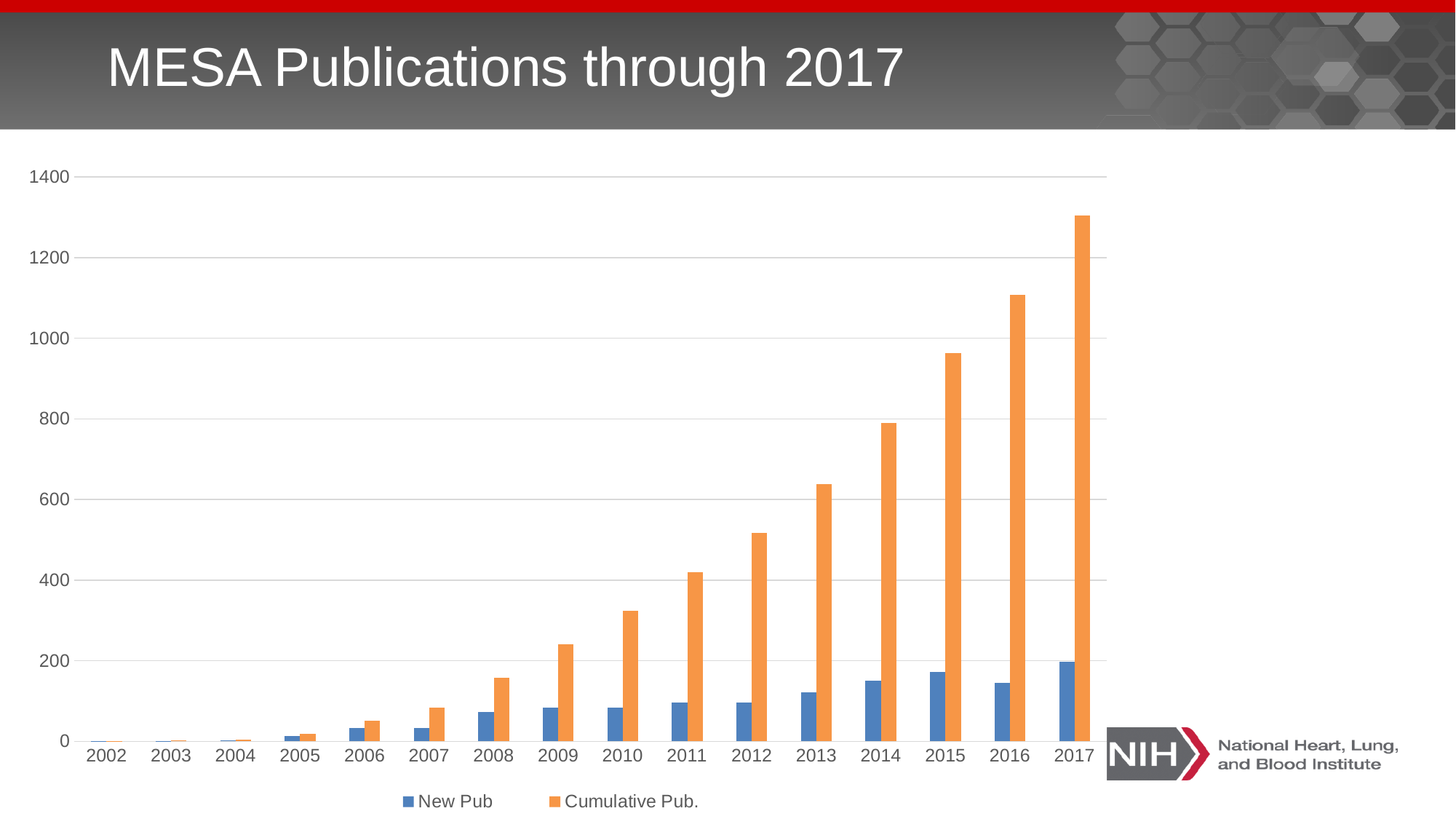
Which year has the lowest Cumulative Pub. value? 2002 What is the title of the slide containing the chart? MESA Publications through 2017 Which is larger, the New Pub value for 2015 or for 2016? 2015 Is the Cumulative Pub. value for 2017 greater or less than 1200? greater Which year has the highest Cumulative Pub. value? 2017 How many years are shown on the x axis? 16 Is the New Pub value for 2015 greater or less than 200? less How many series does the legend list? 2 Is the Cumulative Pub. value for 2013 greater or less than 600? greater What kind of chart is shown on the slide? bar chart Do the Cumulative Pub. values rise or fall from 2002 to 2017? rise